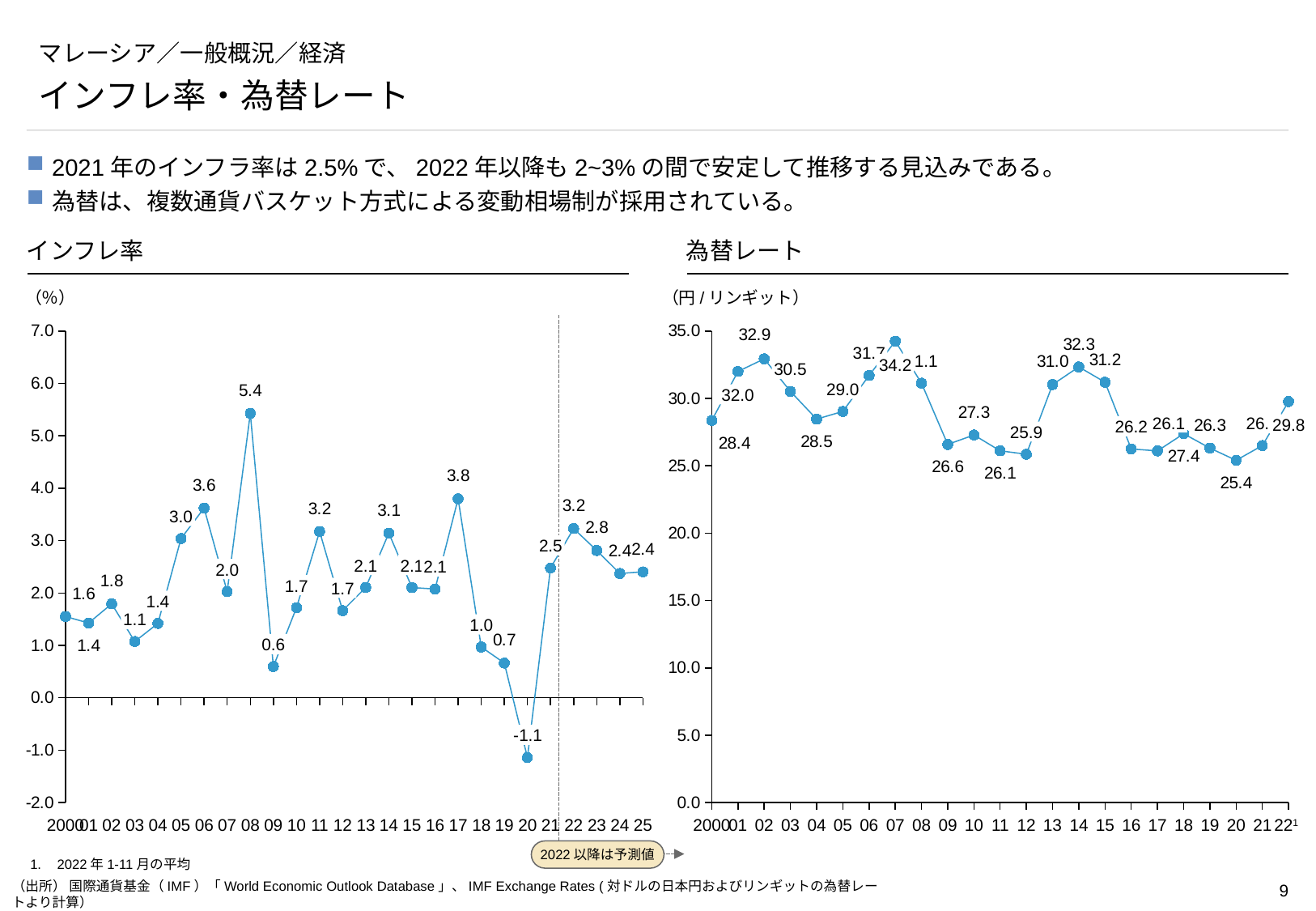
On the 為替レート chart, what is the value for 2007? 34.2 On the 為替レート chart, which is larger, the value for 2002 or the value for 2022? 2002 What kind of chart is the インフレ率 chart? line chart On the インフレ率 chart, what is the difference between the 2008 value and the 2009 value? 4.8 On the 為替レート chart, which year has the lowest exchange rate? 2020 On the インフレ率 chart, what is the value for 2020? -1.1 On the インフレ率 chart, what is the value for 2022? 3.2 On the インフレ率 chart, which year has the lowest inflation rate? 2020 On the 為替レート chart, what is the difference between the 2007 value and the 2020 value? 8.8 On the インフレ率 chart, what is the inflation rate for 2008? 5.4 On the インフレ率 chart, which year has the highest inflation rate? 2008 On the 為替レート chart, is the value for 2009 greater or less than 30.0? less